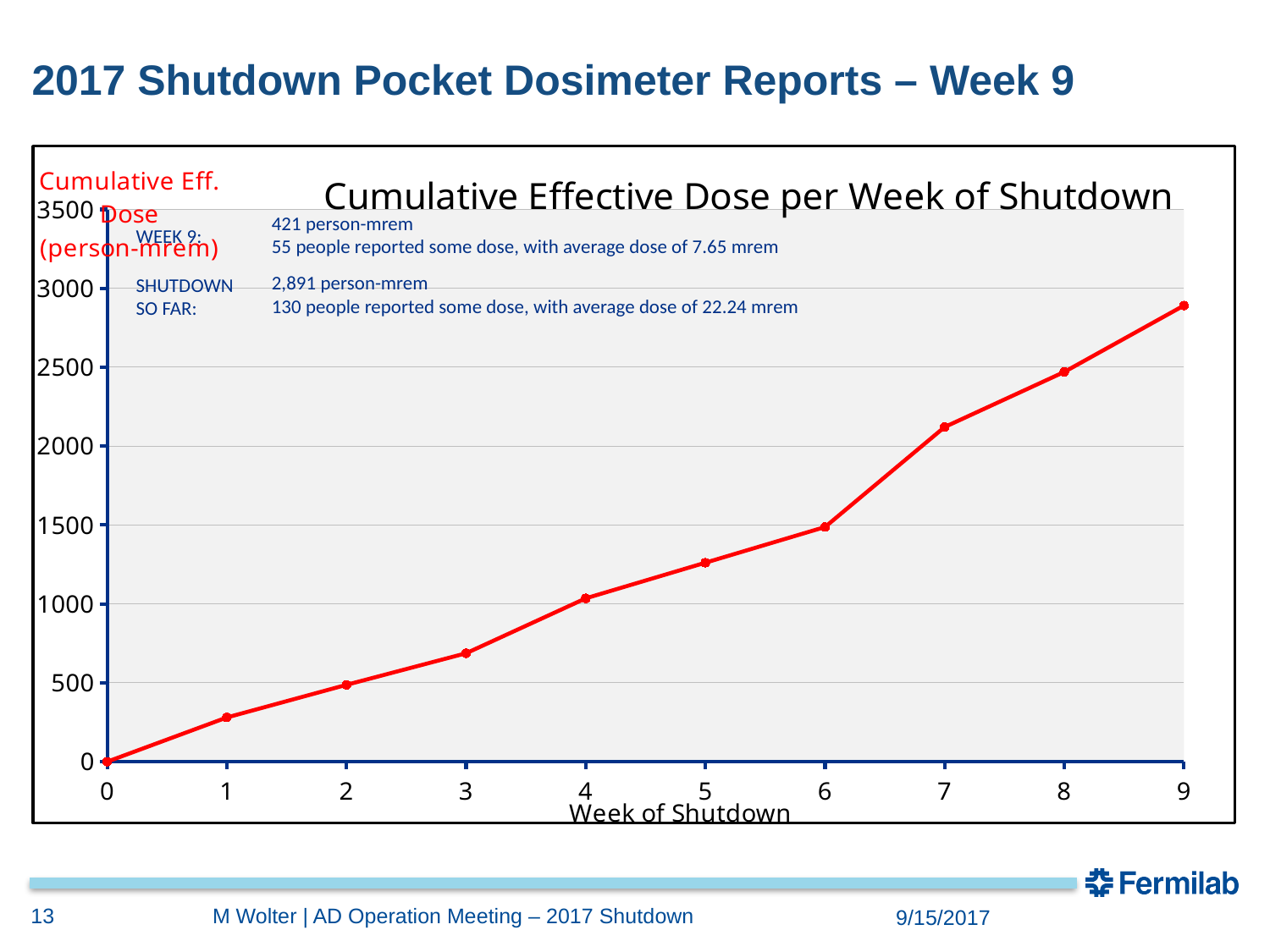
What is the title of the chart? Cumulative Effective Dose per Week of Shutdown What is the label of the x axis? Week of Shutdown Is the cumulative effective dose at week 7 greater or less than 2000? greater At which week of shutdown is the cumulative effective dose lowest? 0 What is the cumulative effective dose at week 0? 0 Does the cumulative effective dose rise or fall as the week of shutdown increases? rises Is the cumulative effective dose at week 3 greater or less than 500? greater At which week of shutdown is the cumulative effective dose highest? 9 Which is larger, the cumulative effective dose at week 5 or at week 7? week 7 Is the cumulative effective dose at week 1 greater or less than 500? less How many data points are plotted on the line? 10 What kind of chart is shown on the slide? line chart